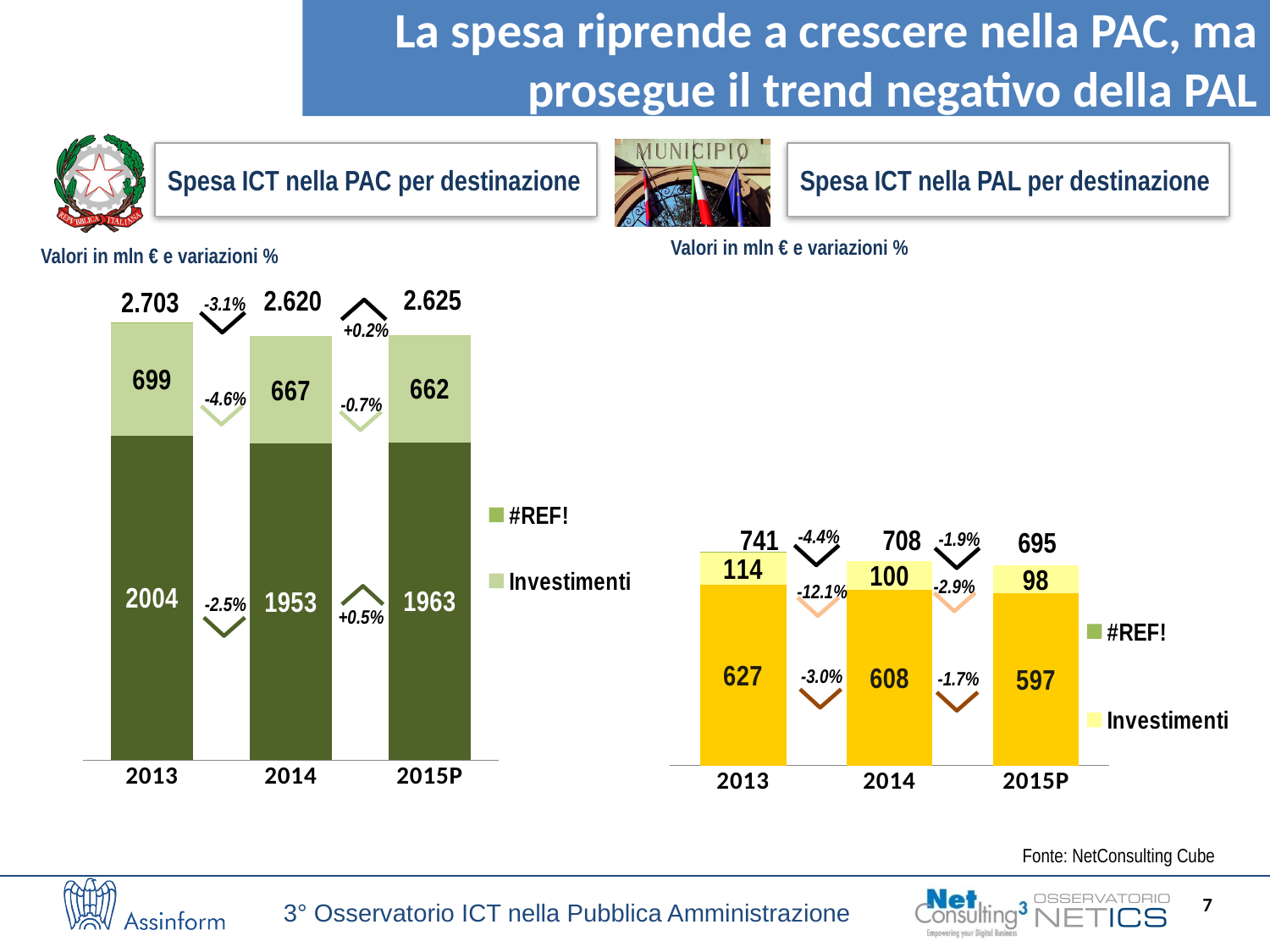
In the 'Spesa ICT nella PAC per destinazione' chart, what is the value of the lower (dark green) segment for 2014? 1953 In the 'Spesa ICT nella PAC per destinazione' chart, what is the difference between the upper segment values for 2013 and 2014? 32 How many year categories are shown on the x axis of the 'Spesa ICT nella PAL per destinazione' chart? 3 What kind of chart is the 'Spesa ICT nella PAC per destinazione' chart? stacked bar chart In the 'Spesa ICT nella PAL per destinazione' chart, what is the value of the upper (light yellow) segment for 2014? 100 In the 'Spesa ICT nella PAC per destinazione' chart, what is the value of the upper (light green) segment for 2015P? 662 In the 'Spesa ICT nella PAL per destinazione' chart, do the totals rise or fall from 2013 to 2015P? fall In the 'Spesa ICT nella PAL per destinazione' chart, what is the value of the lower (orange) segment for 2013? 627 In the 'Spesa ICT nella PAL per destinazione' chart, what is the difference between the lower segment values for 2014 and 2015P? 11 In the 'Spesa ICT nella PAC per destinazione' chart, what is the total value shown above the 2013 bar? 2.703 In the 'Spesa ICT nella PAL per destinazione' chart, what is the total value shown above the 2015P bar? 695 In the 'Spesa ICT nella PAC per destinazione' chart, which year has the highest total? 2013